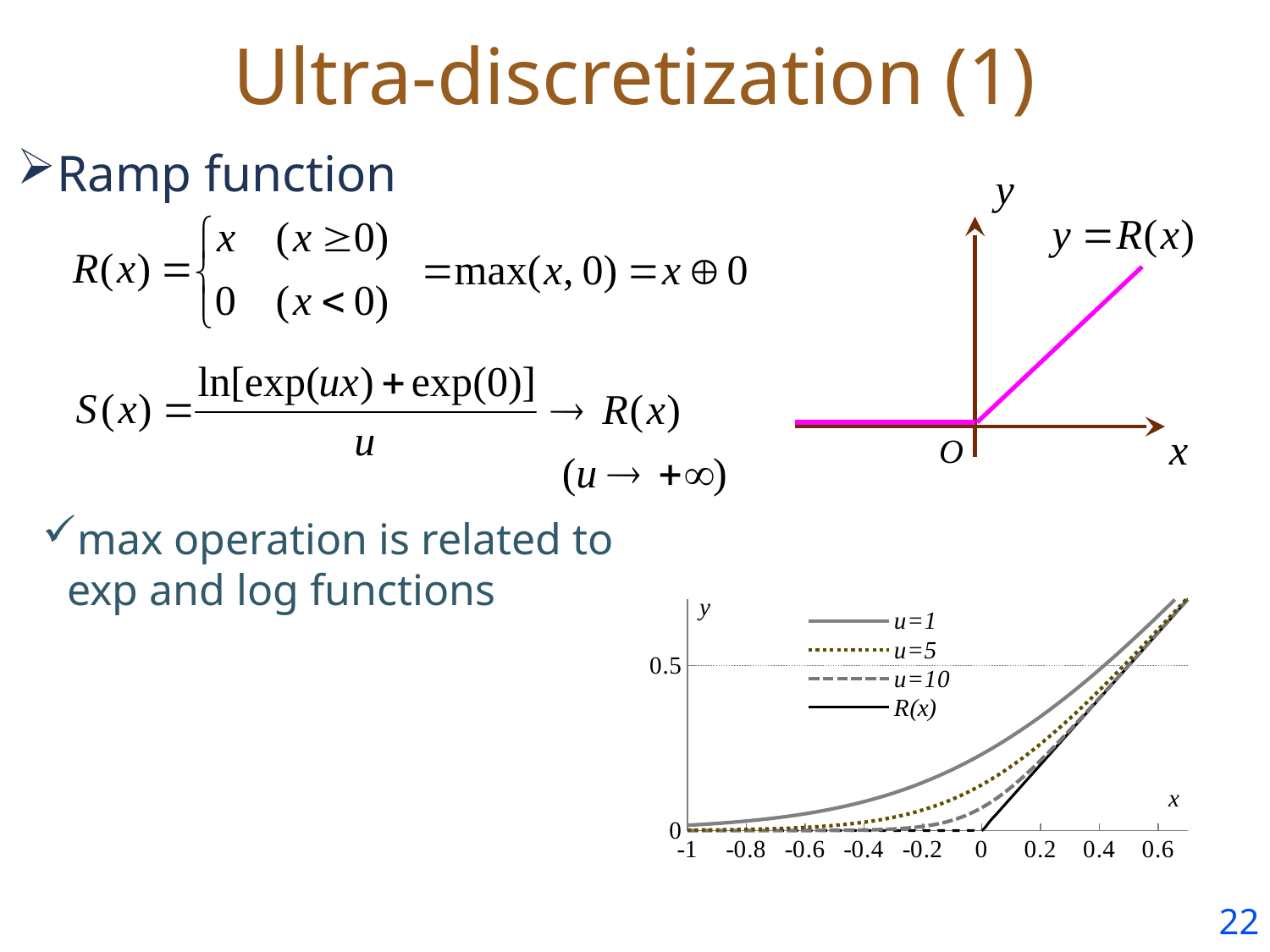
In the bottom-right chart, how many tick labels are shown on the x axis? 9 In the bottom-right chart, what is the value of R(x) at x=0? 0 In the bottom-right chart, what are the legend entries? u=1, u=5, u=10, R(x) In the bottom-right chart, how many series does the legend list? 4 In the bottom-right chart, do the values of the u=1 series rise or fall as x increases? rise In the bottom-right chart, is the value of the u=1 series at x=0 greater or less than 0.5? less What kind of chart is the bottom-right chart? line chart In the bottom-right chart, which series has the highest value at x=0? u=1 In the bottom-right chart, is the value of the u=1 series at x=0.6 greater or less than 0.5? greater What function is plotted in the top-right chart, according to its label? y = R(x) In the bottom-right chart, at x=0, which is larger: the u=1 series or the u=10 series? u=1 In the bottom-right chart, which series is drawn as a solid black line? R(x)